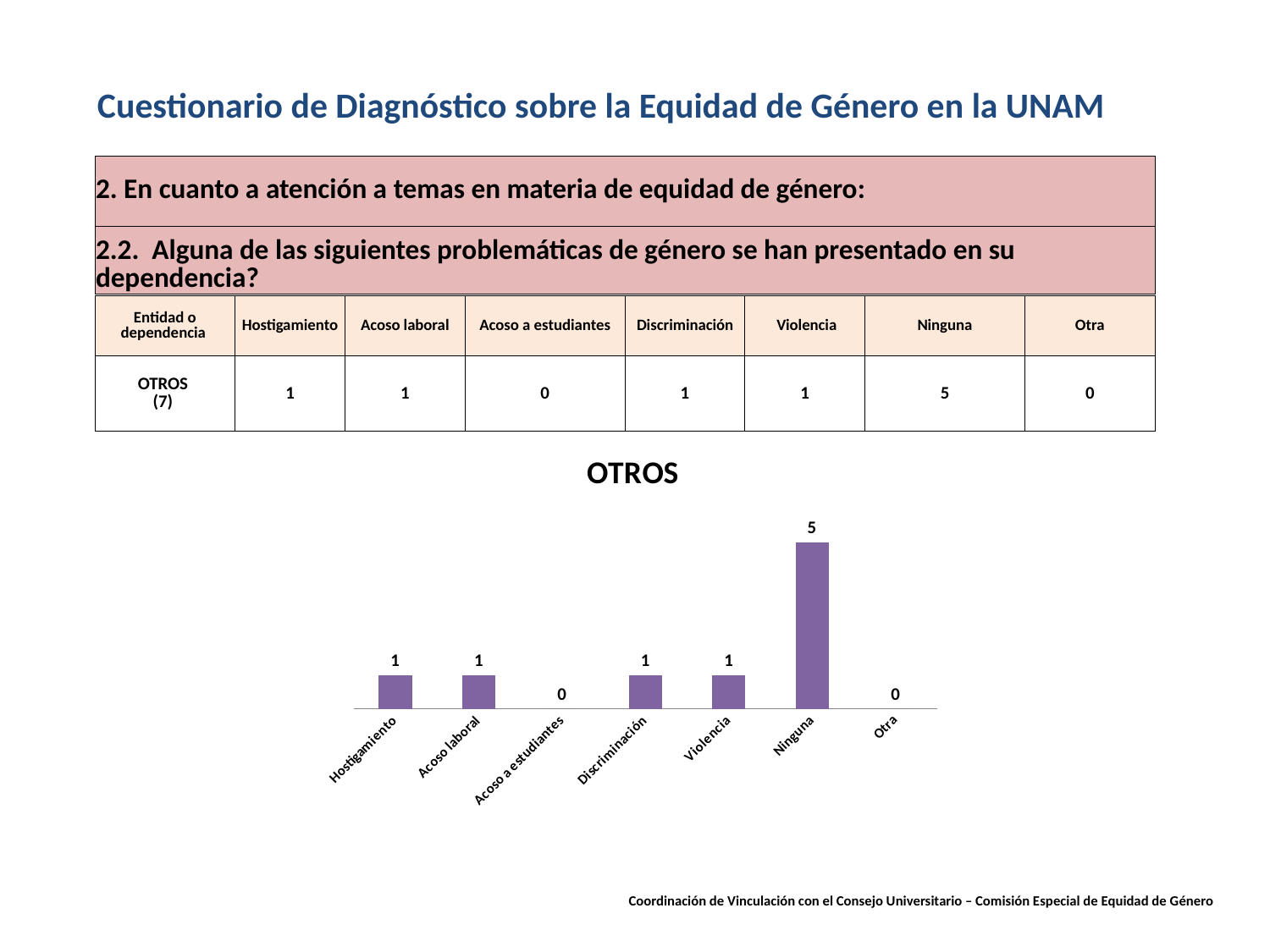
What is the title of the chart on the slide? OTROS How many categories are shown on the x axis of the OTROS chart? 7 What is the value for Acoso a estudiantes in the OTROS chart? 0 What is the difference between the values for Ninguna and Discriminación in the OTROS chart? 4 What is the value for Hostigamiento in the OTROS chart? 1 Which category has the highest value in the OTROS chart? Ninguna How many categories in the OTROS chart have a value of 0? 2 What is the value for Violencia in the OTROS chart? 1 What is the value for Ninguna in the OTROS chart? 5 What kind of chart is shown on the slide? Bar chart Which is larger in the OTROS chart, the value for Acoso laboral or the value for Otra? Acoso laboral What is the total of all the values plotted in the OTROS chart? 9